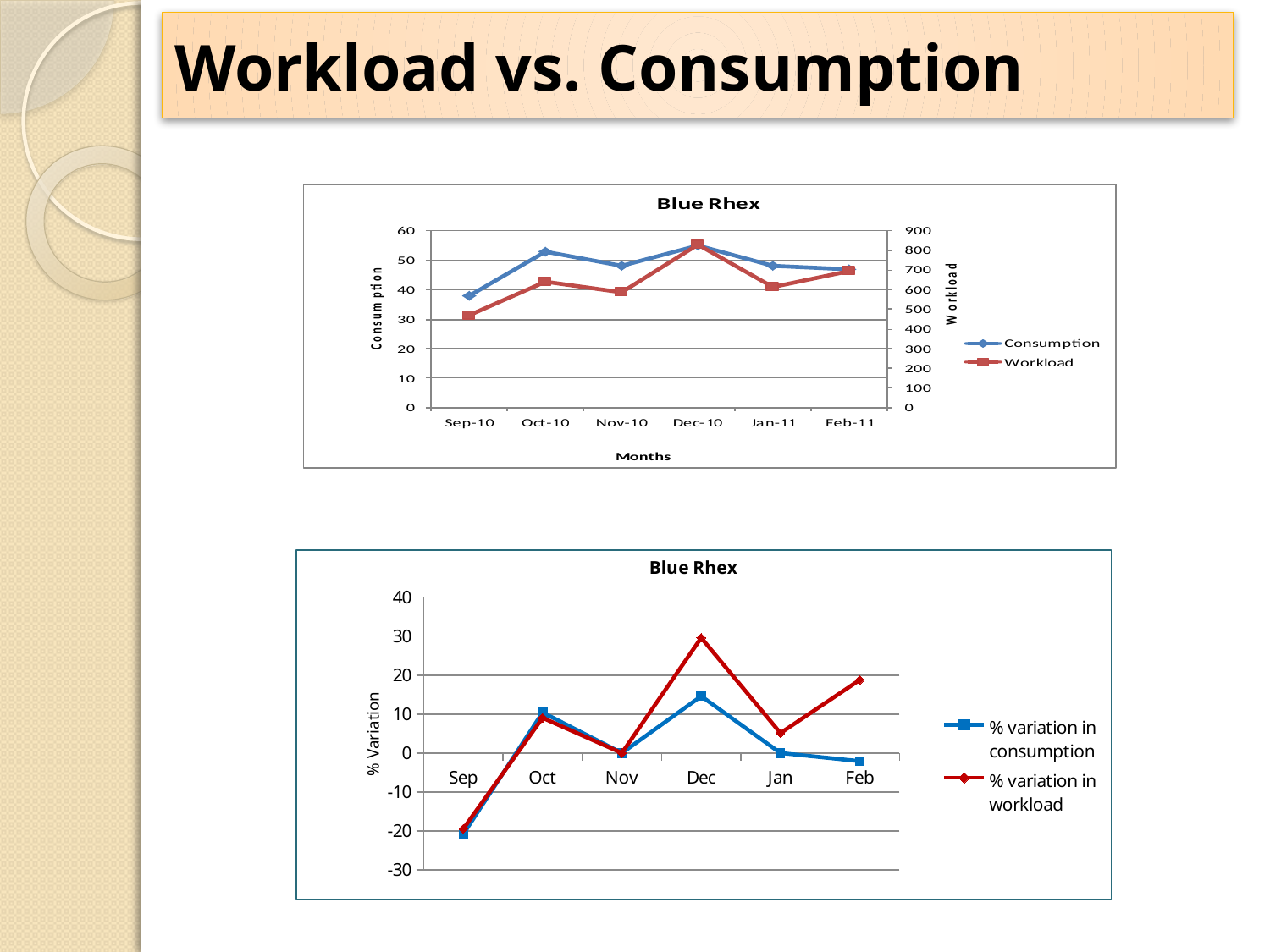
In the bottom chart, is the % variation in consumption for Sep greater or less than -10? less In the top chart, which month has the highest Consumption value? Dec-10 How many series does the legend of the bottom chart list? 2 What kind of chart is the top chart on the slide? line chart In the top chart, is the Consumption value for Sep-10 greater or less than 40? less In the bottom chart, which month has the highest % variation in workload? Dec In the top chart, is the Workload value for Dec-10 greater or less than 700? greater How many months are plotted on the x axis of the top chart? 6 In the top chart, which month has the lowest Workload value? Sep-10 In the top chart, what is the label of the right-hand vertical axis? Workload In the bottom chart, which is larger in Feb: % variation in consumption or % variation in workload? % variation in workload How many series does the legend of the top chart list? 2